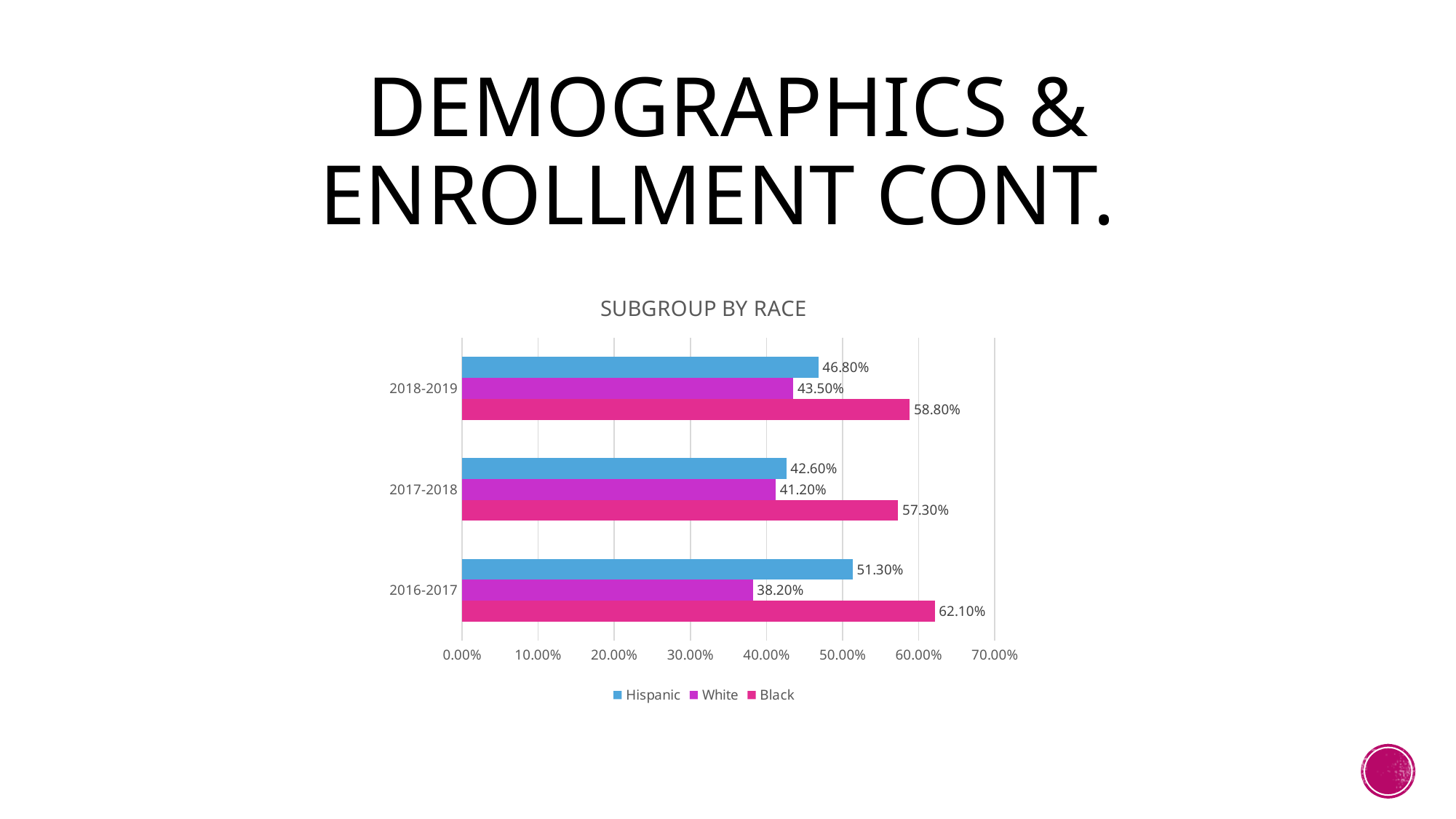
How many series does the legend list? 3 Which year has the highest value for Black? 2016-2017 Is the value for Black in 2017-2018 greater or less than 50.00%? greater What is the value for Hispanic in 2017-2018? 42.60% Which year has the lowest value for White? 2016-2017 What is the difference between the Black and White values in 2016-2017? 23.90% How many year categories are shown on the chart? 3 Which is larger in 2018-2019, the Hispanic value or the White value? Hispanic What is the value for Black in 2016-2017? 62.10% What is the title of the chart? SUBGROUP BY RACE What is the value for White in 2018-2019? 43.50% What kind of chart is shown on the slide? Bar chart